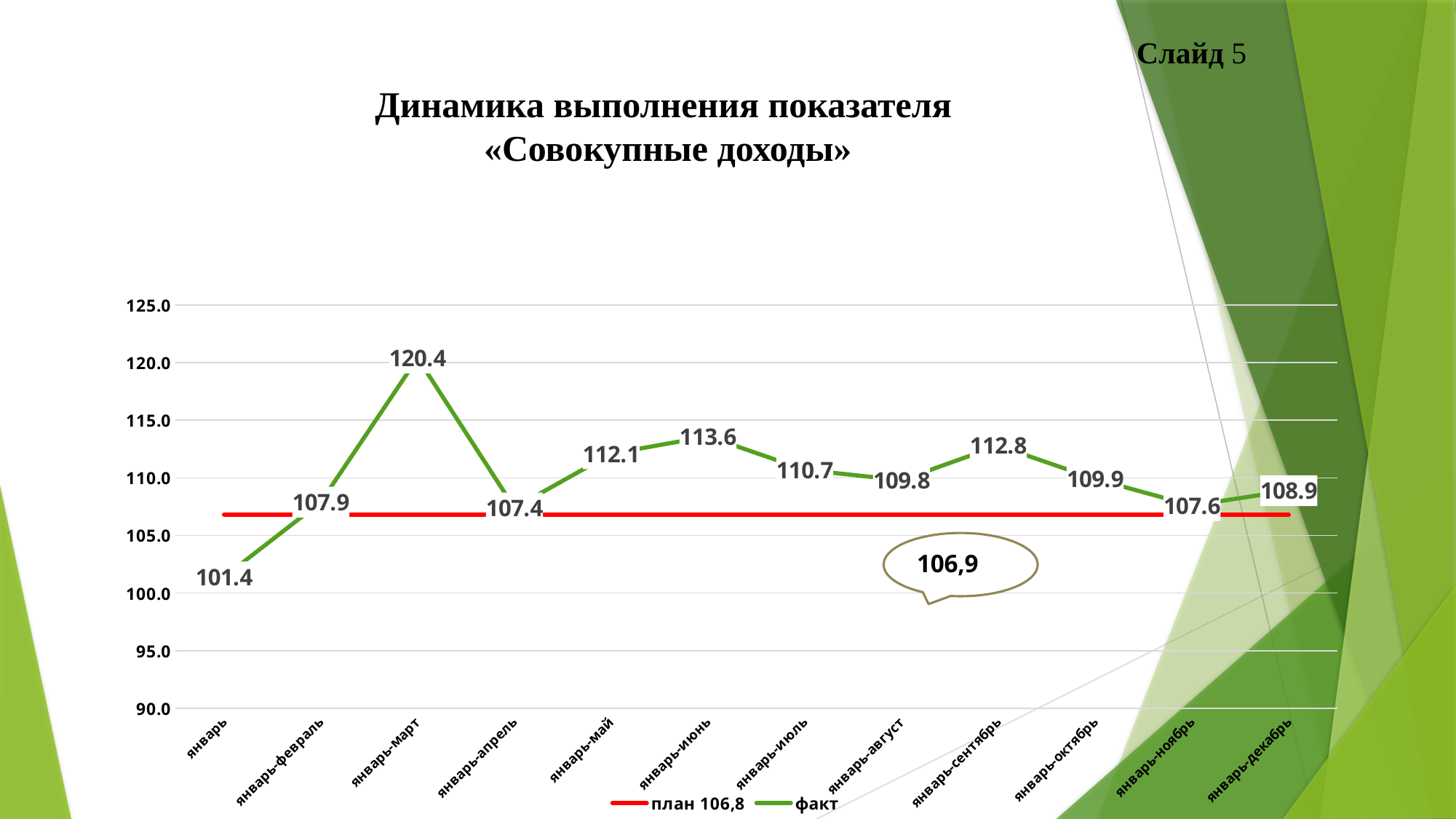
How many series does the legend list? 2 What is the факт value for январь? 101.4 What type of chart is shown on the slide? line chart What is the difference between the факт values for январь-март and январь-апрель? 13.0 What is the факт value for январь-сентябрь? 112.8 Which period has the highest факт value? январь-март Which period has the lowest факт value? январь What is the факт value for январь-декабрь? 108.9 How many periods are shown on the x axis? 12 What is the факт value for январь-март? 120.4 What are the two legend entries of the chart? план 106,8 and факт Which is larger, the факт value for январь-июнь or for январь-июль? январь-июнь